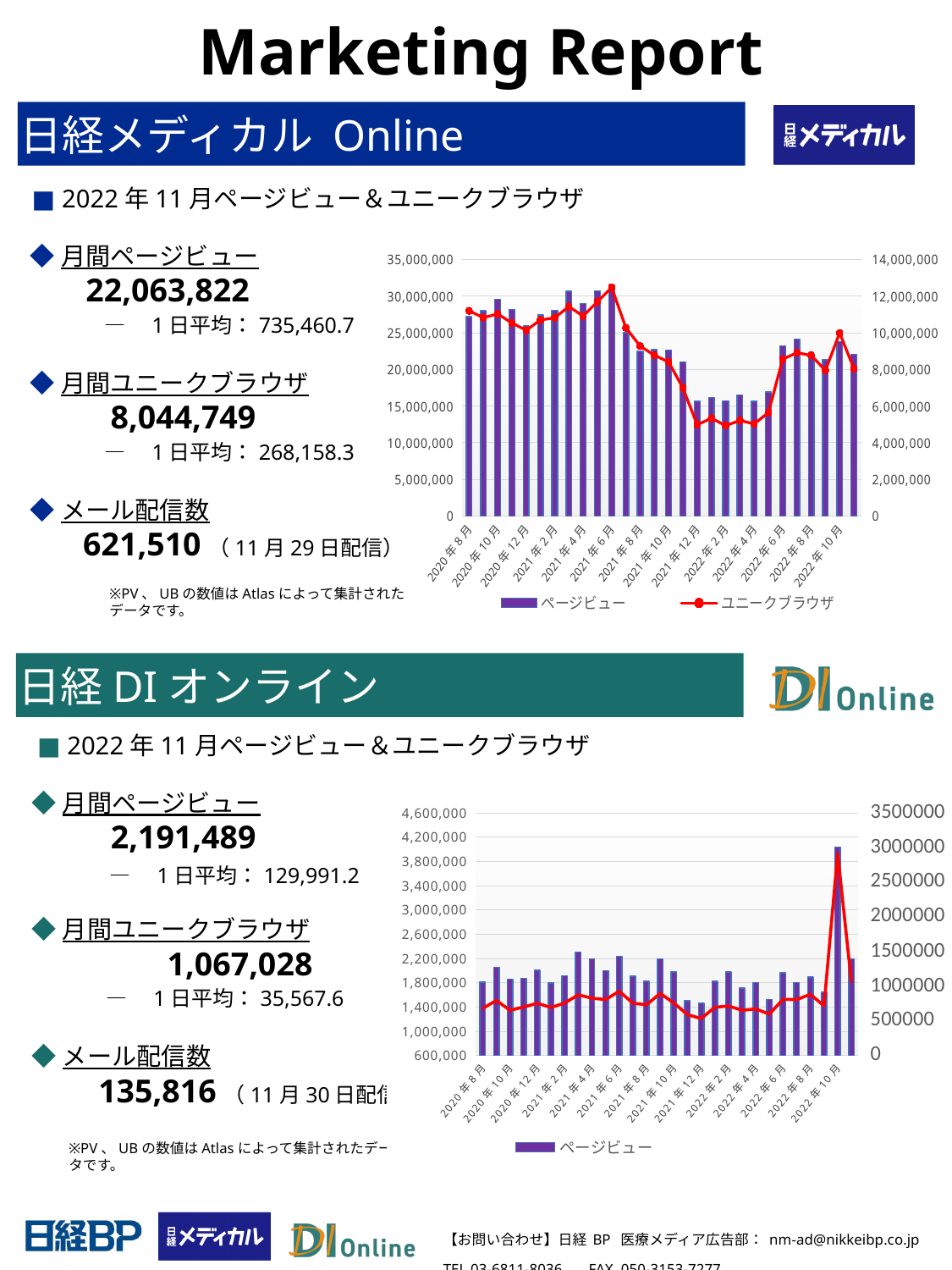
What are the two legend entries of the top chart (日経メディカル Online)? ページビュー and ユニークブラウザ In the top chart (日経メディカル Online), is the ページビュー bar for 2020年8月 greater or less than 25,000,000? greater In the bottom chart (日経 DI オンライン), which is larger, the ページビュー bar for 2021年4月 or for 2021年12月? 2021年4月 In the top chart (日経メディカル Online), is the ユニークブラウザ value for 2022年2月 greater or less than 8,000,000 on the right axis? less How many x-axis labels are shown on the bottom chart (日経 DI オンライン)? 14 What kind of chart is the 日経メディカル Online chart (top chart)? bar and line chart How many series does the legend of the bottom chart (日経 DI オンライン) list? 1 In the top chart (日経メディカル Online), is the ページビュー bar for 2022年2月 greater or less than 20,000,000? less In the top chart (日経メディカル Online), which is larger, the ページビュー bar for 2020年8月 or for 2022年2月? 2020年8月 In the top chart (日経メディカル Online), do the ページビュー bars rise or fall from 2021年6月 to 2021年12月? fall How many series does the legend of the top chart (日経メディカル Online) list? 2